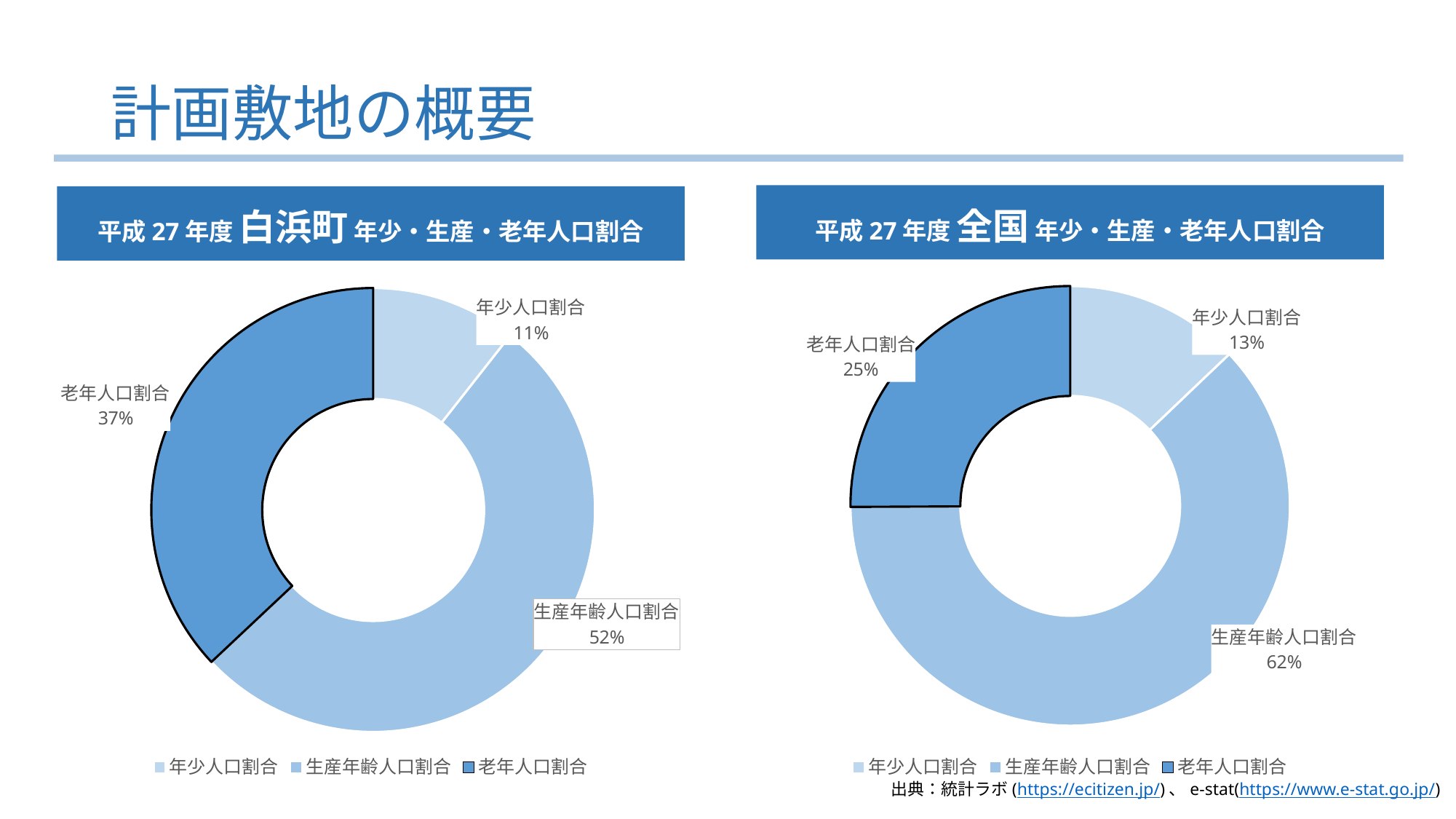
In the 白浜町 chart (left), what is the value for 年少人口割合? 11% In the 白浜町 chart (left), what is the difference between 生産年齢人口割合 and 老年人口割合? 15% In the 全国 chart (right), which category has the smallest share? 年少人口割合 In the 全国 chart (right), what is the value for 生産年齢人口割合? 62% What kind of chart is the 全国 chart (right)? Doughnut chart In the 白浜町 chart (left), what is the value for 老年人口割合? 37% Which is larger: 生産年齢人口割合 in the 白浜町 chart (left) or 生産年齢人口割合 in the 全国 chart (right)? 全国 chart (right) How many categories does the 白浜町 chart (left) show? 3 In the 白浜町 chart (left), which category has the largest share? 生産年齢人口割合 How many entries does the legend of the 全国 chart (right) list? 3 What is the difference between 老年人口割合 in the 白浜町 chart (left) and 老年人口割合 in the 全国 chart (right)? 12% In the 全国 chart (right), what is the value for 老年人口割合? 25%